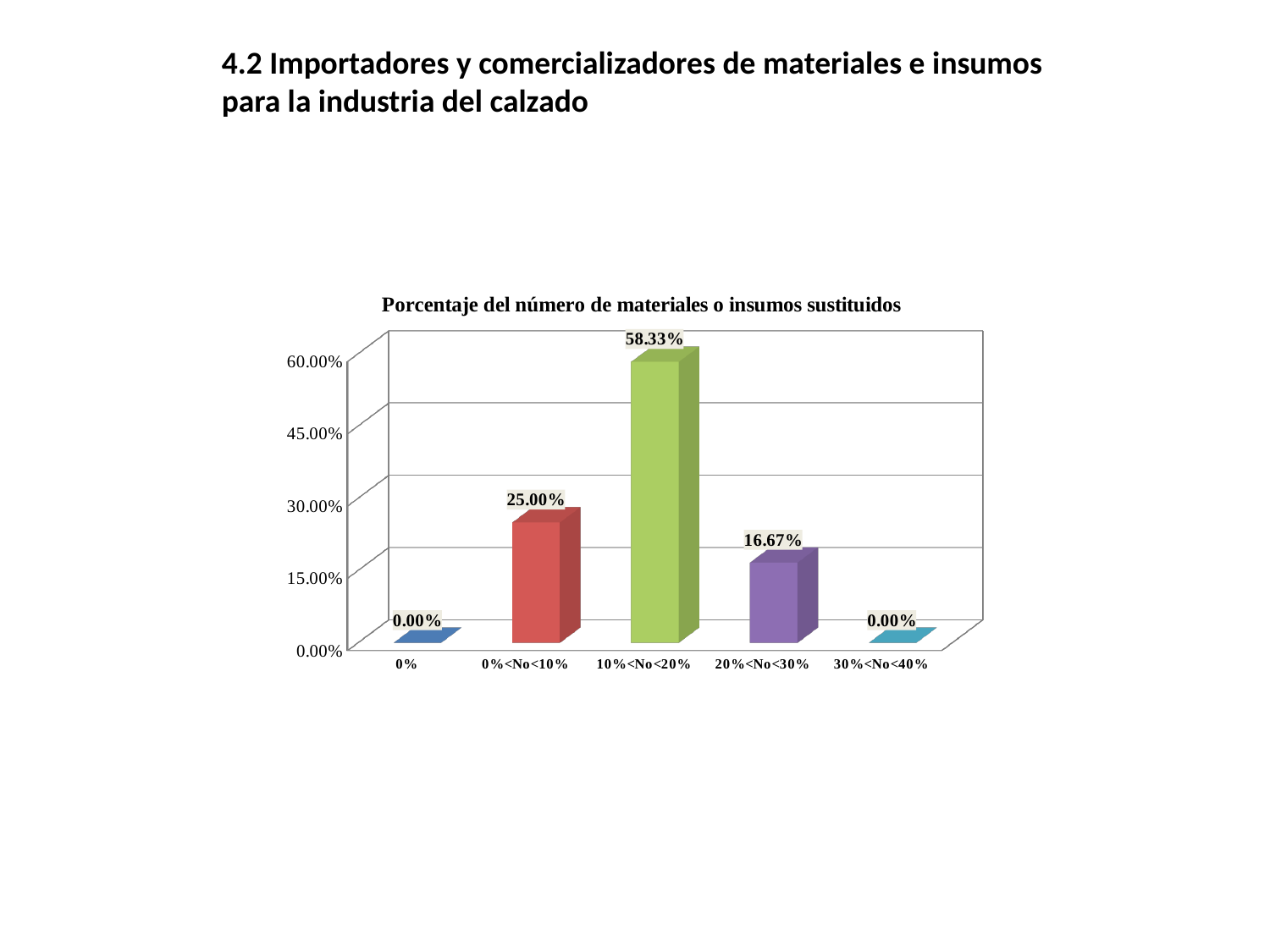
What is the difference between the values for 10%<No<20% and 0%<No<10%? 33.33% What is the value for the 30%<No<40% category? 0.00% How many categories are shown on the x axis? 5 What kind of chart is shown on the slide? bar chart Which is larger, the value for 0%<No<10% or the value for 20%<No<30%? 0%<No<10% Which category has the highest value? 10%<No<20% What is the value for the 0%<No<10% category? 25.00% What is the difference between the values for 0%<No<10% and 20%<No<30%? 8.33% What is the value for the 10%<No<20% category? 58.33% What is the value for the 20%<No<30% category? 16.67% Is the value for 10%<No<20% greater or less than 45.00%? greater What is the title of the chart? Porcentaje del número de materiales o insumos sustituidos